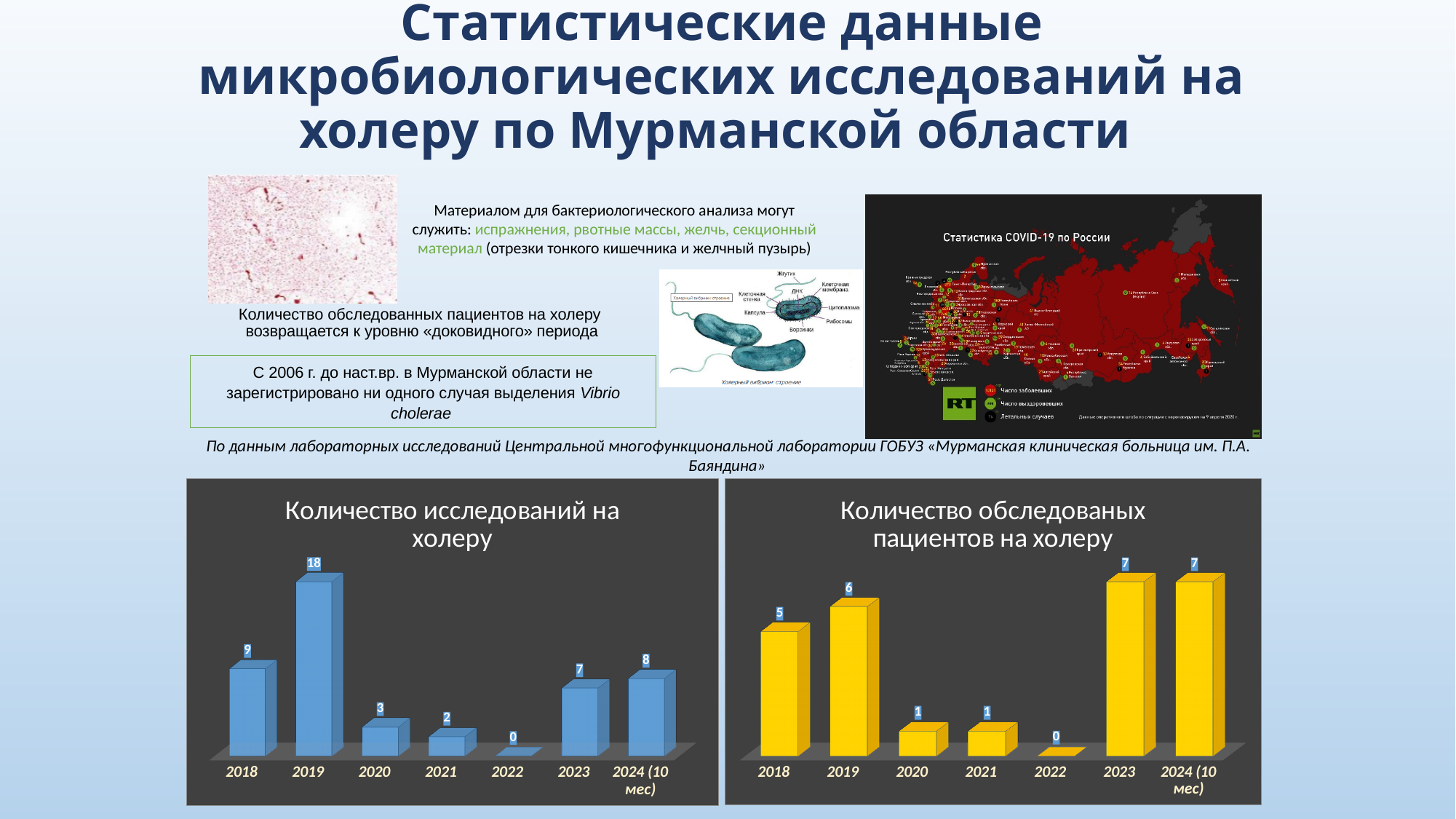
What type of chart is "Количество обследованых пациентов на холеру"? bar chart In the chart "Количество исследований на холеру", how many categories are shown on the x axis? 7 In the chart "Количество обследованых пациентов на холеру", what is the difference between the values for 2023 and 2019? 1 In the chart "Количество исследований на холеру", which year has the lowest value? 2022 In the chart "Количество исследований на холеру", which year has the highest value? 2019 In the chart "Количество обследованых пациентов на холеру", what is the value for 2021? 1 In the chart "Количество исследований на холеру", what is the difference between the values for 2019 and 2018? 9 In the chart "Количество исследований на холеру", what is the value for 2019? 18 In the chart "Количество обследованых пациентов на холеру", what is the value for 2018? 5 In the chart "Количество обследованых пациентов на холеру", which is larger, the value for 2019 or the value for 2023? 2023 In the chart "Количество исследований на холеру", what is the value for 2024 (10 мес)? 8 What colour are the bars in the chart "Количество исследований на холеру"? blue